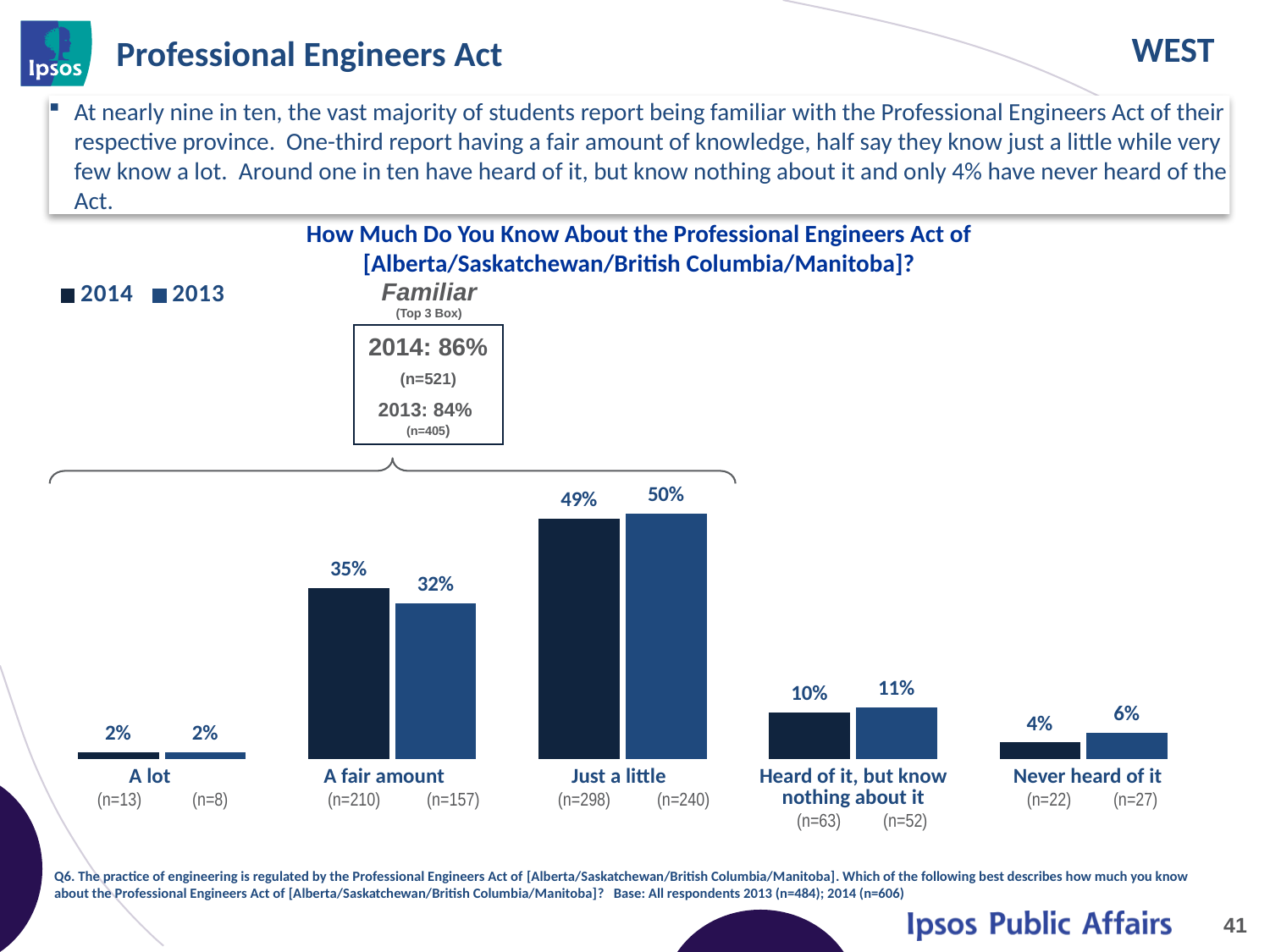
What kind of chart is shown on the slide? Bar chart Which category has the lowest value for 2013? A lot Which category has the highest value for 2014? Just a little How many series does the chart legend list? 2 What is the difference between the 2014 and 2013 values for 'A fair amount'? 3 percentage points Which is larger: the 2014 value for 'Heard of it, but know nothing about it' or the 2013 value for that category? 2013 What is the 'Familiar (Top 3 Box)' percentage for 2014? 86% What percentage of students in 2013 said they know 'Just a little' about the Professional Engineers Act? 50% How many response categories are shown on the x axis of the chart? 5 What percentage of students in 2014 said they know 'A fair amount' about the Professional Engineers Act? 35% What percentage of students in 2013 had 'Never heard of it'? 6% What are the two series listed in the chart legend? 2014 and 2013